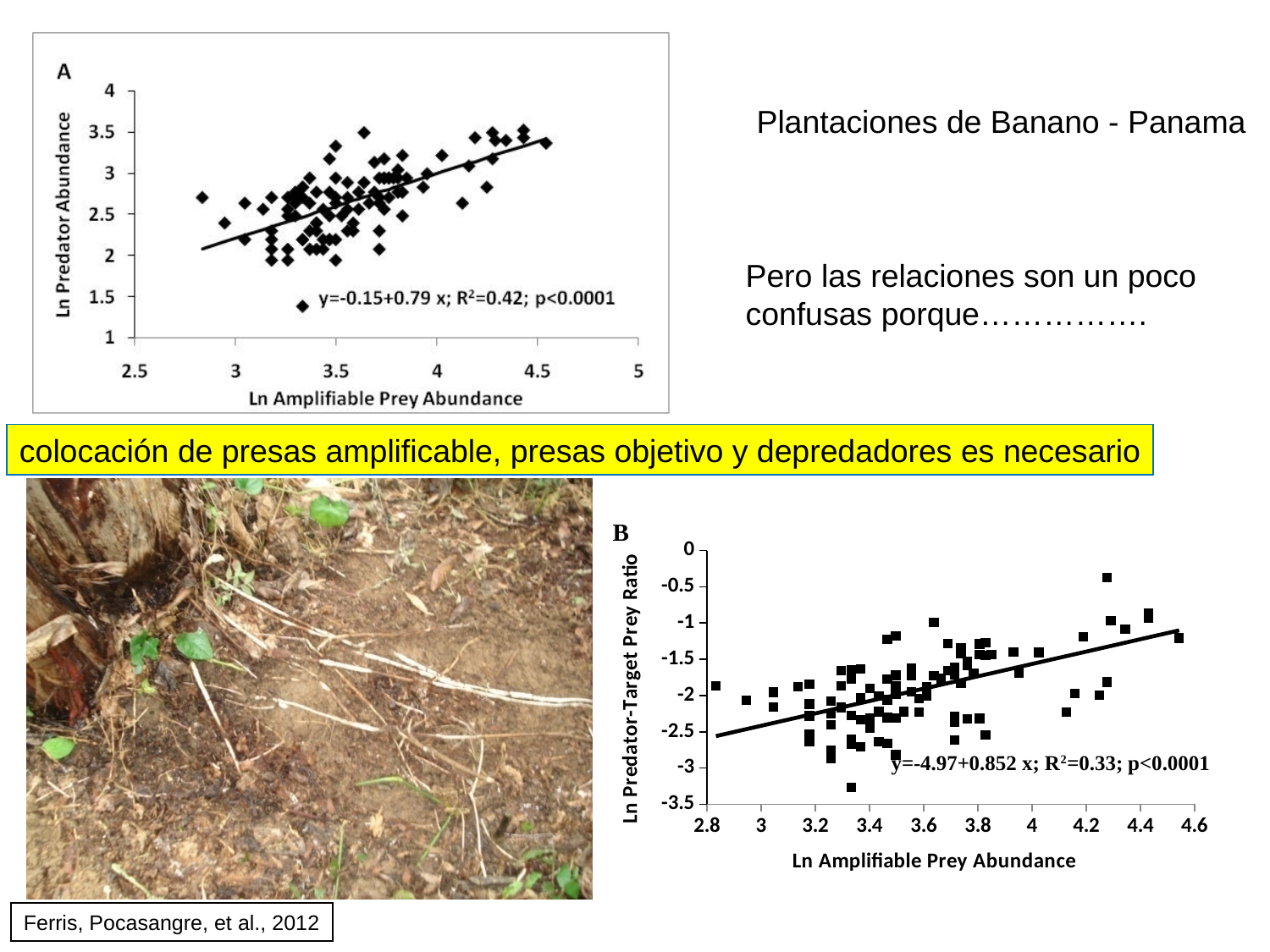
In chart B, does the Ln Predator-Target Prey Ratio rise or fall as Ln Amplifiable Prey Abundance increases? rise What kind of chart is chart B (bottom right)? scatter plot What is the R² value printed on chart B? 0.33 What is the regression equation printed on chart B? y=-4.97+0.852 x What is the label of the x axis in chart A? Ln Amplifiable Prey Abundance What is the difference between the R² values of chart A and chart B? 0.09 Which chart has the higher R² value, chart A or chart B? chart A What is the R² value printed on chart A? 0.42 What is the regression equation printed on chart A? y=-0.15+0.79 x In chart A, do the values of Ln Predator Abundance rise or fall as Ln Amplifiable Prey Abundance increases? rise What is the label of the y axis in chart B? Ln Predator-Target Prey Ratio What kind of chart is chart A (top left)? scatter plot